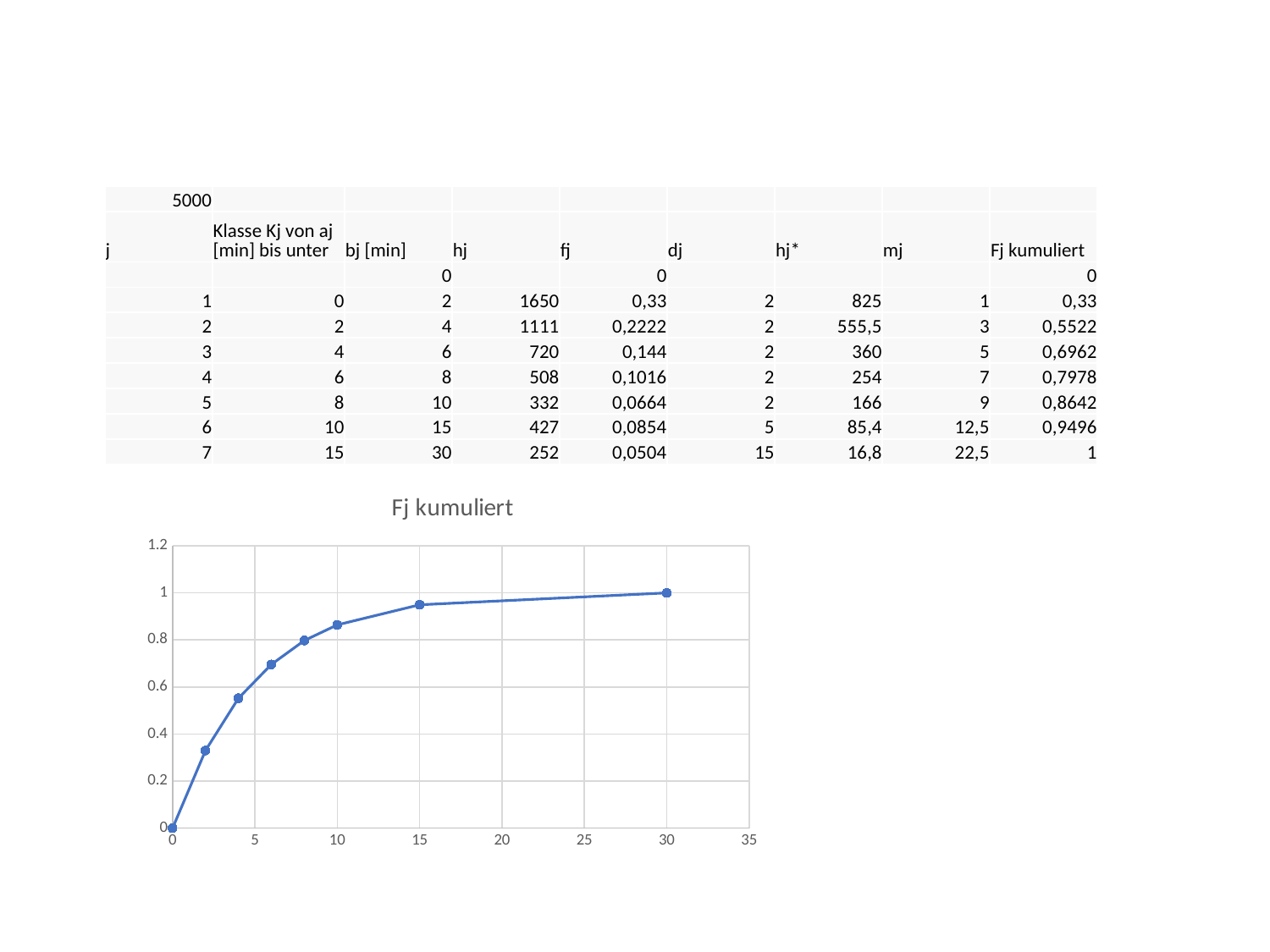
What is the plotted value at x = 0? 0 What is the plotted value at x = 30? 1 What is the highest tick value shown on the x axis? 35 Do the plotted values rise or fall as x increases along the axis? rise What is the title of the chart? Fj kumuliert How many data points are plotted on the chart? 8 Is the plotted value at x = 2 greater or less than 0.4? less Is the plotted value at x = 10 greater or less than 0.8? greater Is the plotted value at x = 4 greater or less than 0.6? less What kind of chart is shown on the slide? line chart At which x value does the chart reach its highest point? 30 Which is larger, the plotted value at x = 8 or at x = 15? x = 15